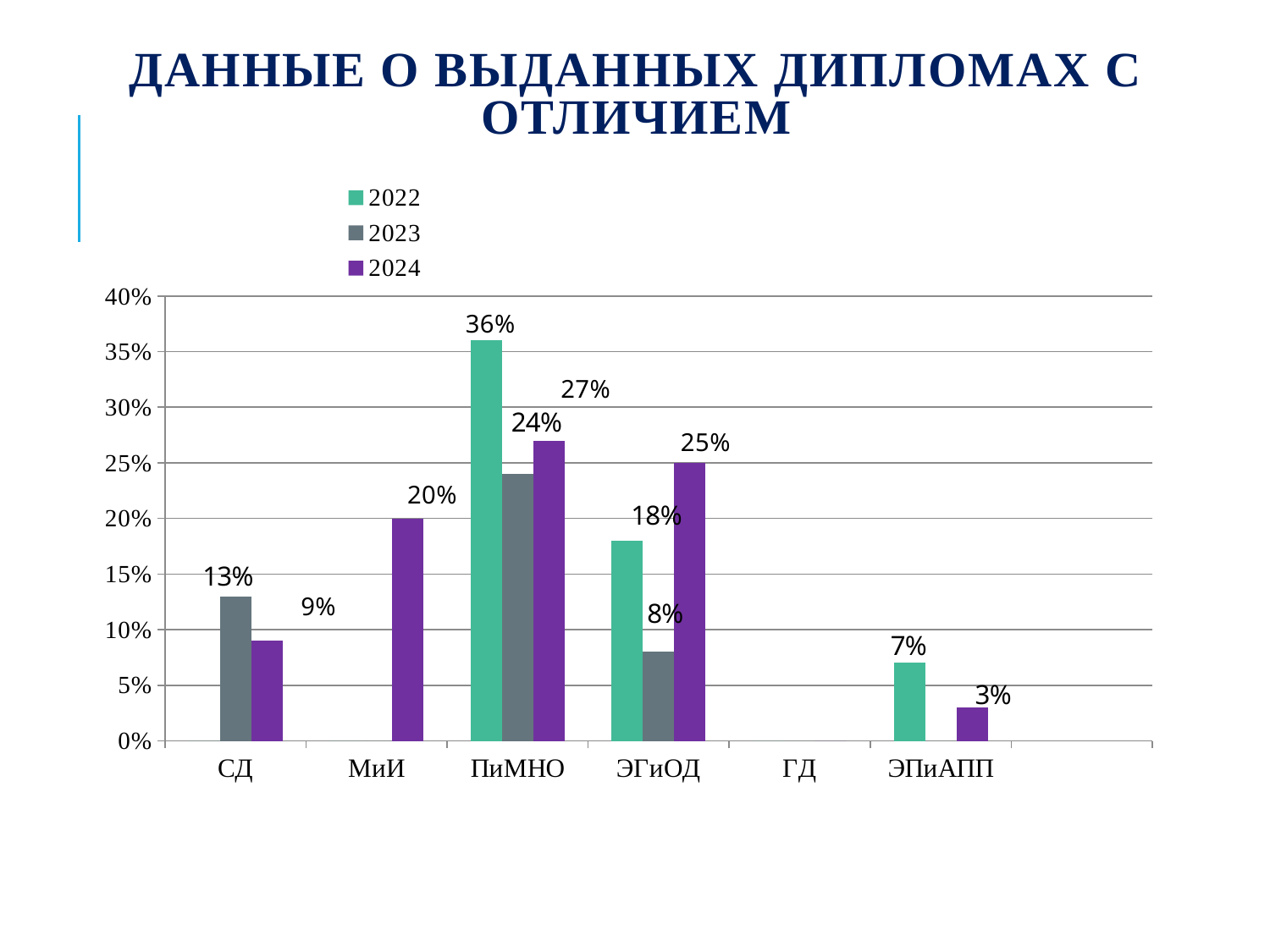
What is the value for ЭПиАПП in 2024? 3% Which category has the highest value in the 2024 series? ПиМНО What is the value for СД in 2023? 13% What is the value for ЭГиОД in 2024? 25% What is the value for ПиМНО in 2022? 36% How many categories are shown on the x axis? 6 What is the difference between the 2022 and 2023 values for ПиМНО? 12% What type of chart is shown on the slide? bar chart How many series does the legend list? 3 What is the title of the chart? ДАННЫЕ О ВЫДАННЫХ ДИПЛОМАХ С ОТЛИЧИЕМ Which is larger: the 2024 value for МиИ or the 2024 value for СД? МиИ